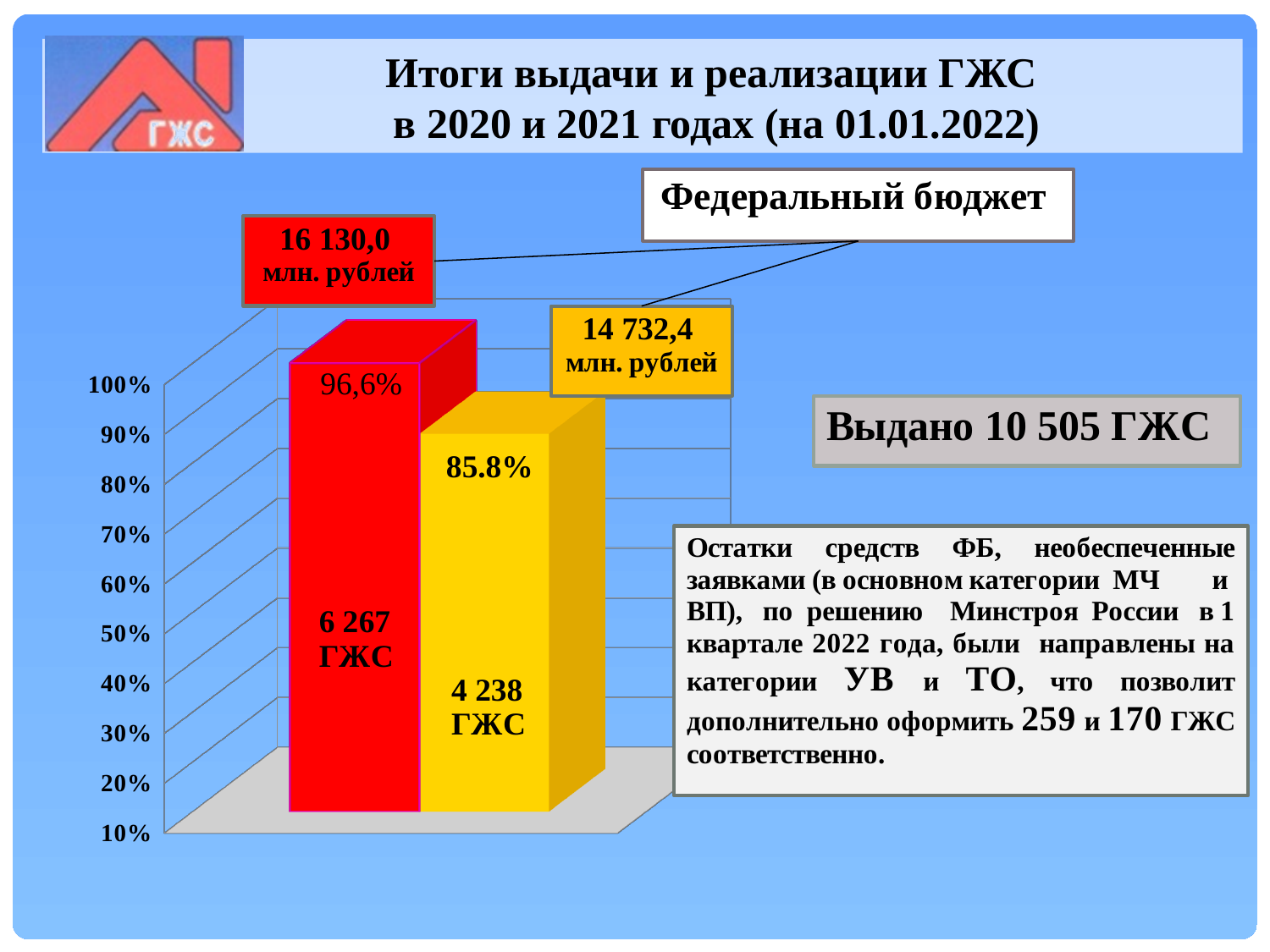
What is the difference in percentage points between the red bar (96,6%) and the yellow bar (85.8%)? 10.8 percentage points Is the value of the yellow bar greater or less than 80%? greater How many ГЖС are labelled on the yellow bar? 4 238 ГЖС What percentage is labelled on the yellow bar? 85.8% What kind of chart is shown on the slide? bar chart What percentage is labelled on the red bar? 96,6% What federal budget amount (млн. рублей) is shown in the red callout box linked to the red bar? 16 130,0 млн. рублей How many ГЖС are labelled on the red bar? 6 267 ГЖС Which bar is taller, the red one or the yellow one? the red bar How many bars does the chart contain? 2 What is the title of the slide containing the chart? Итоги выдачи и реализации ГЖС в 2020 и 2021 годах (на 01.01.2022) What is the difference between the number of ГЖС on the red bar and on the yellow bar? 2 029